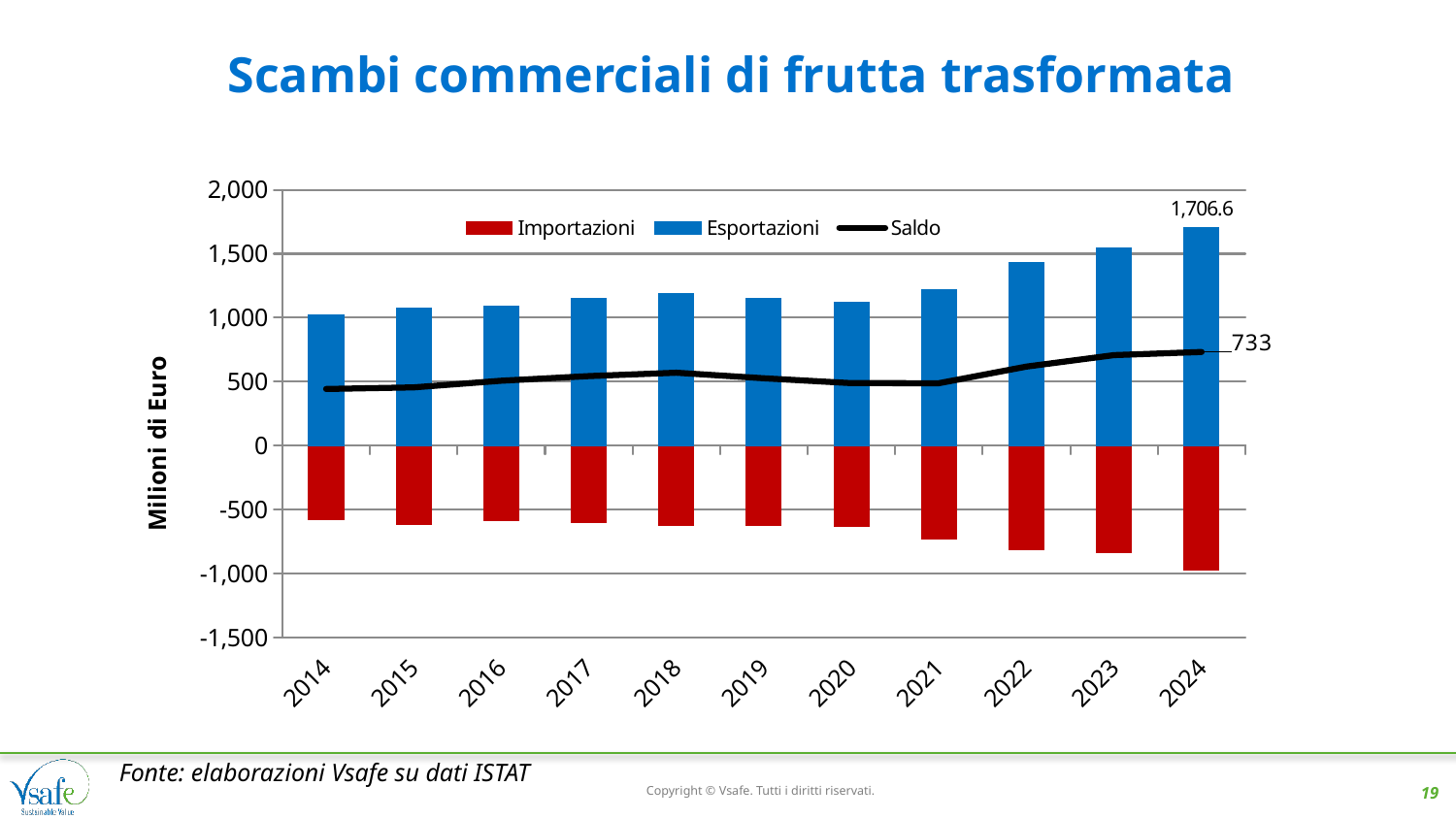
What is the value of Saldo in 2024? 733 How many years are shown on the x axis? 11 How many series does the legend list? 3 What is the unit shown on the y axis label? Milioni di Euro Is the value for Importazioni in 2024 greater or less than -500? less In which year is the Importazioni bar largest in magnitude (most negative)? 2024 In which year is Esportazioni highest? 2024 What is the value of Esportazioni in 2024? 1,706.6 Is the value for Saldo in 2014 greater or less than 500? less Which is larger, Esportazioni in 2021 or Esportazioni in 2022? 2022 Is the value for Esportazioni in 2022 greater or less than 1,000? greater In which year does the Saldo line reach its highest value? 2024